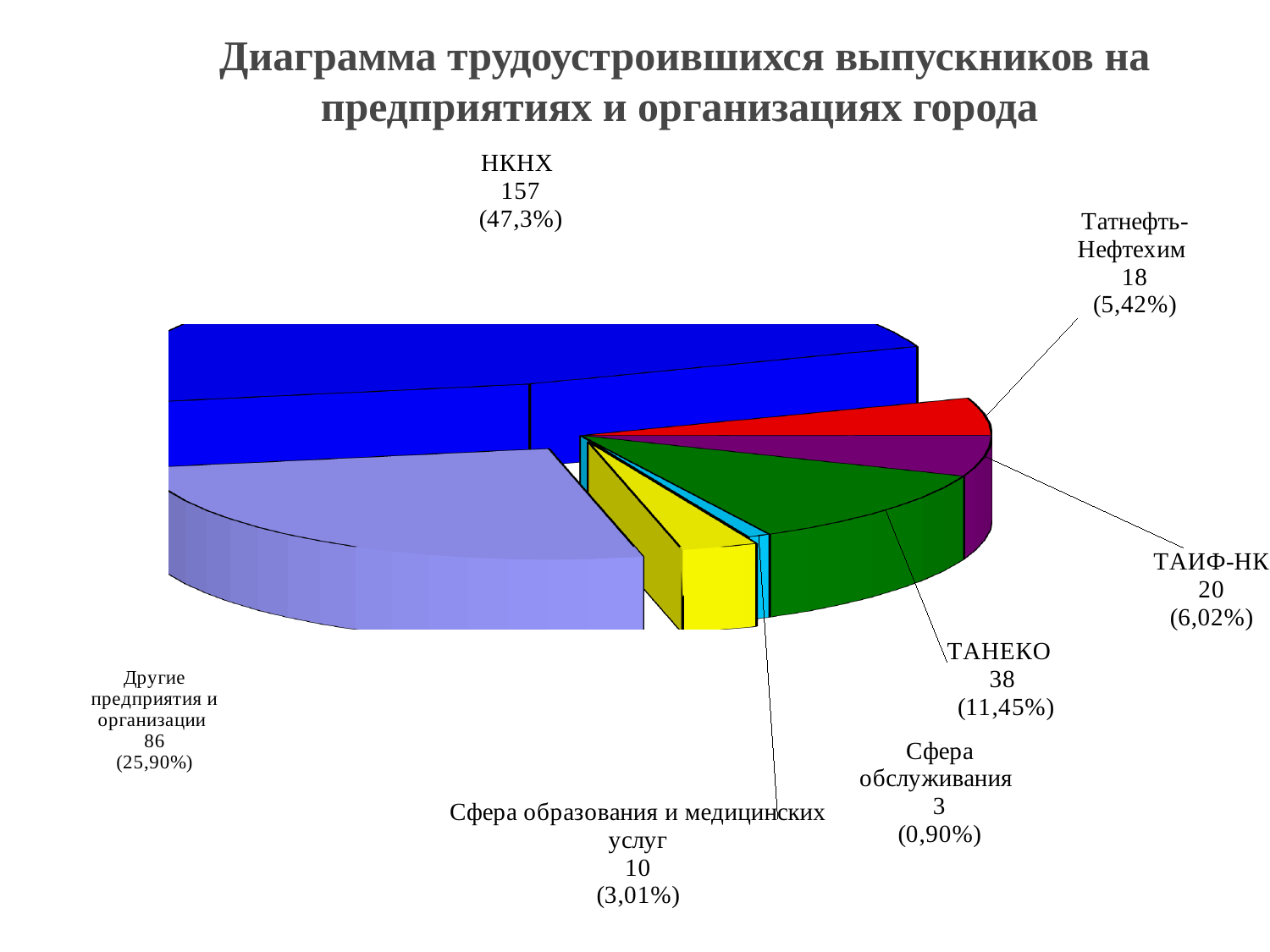
What is the difference between the values for НКНХ and Другие предприятия и организации? 71 What share of the pie does ТАНЕКО represent? 11,45% What share of the pie does Сфера обслуживания represent? 0,90% Which category has the largest slice? НКНХ Which is larger, the value for ТАНЕКО or the value for Сфера образования и медицинских услуг? ТАНЕКО What is the value for Другие предприятия и организации? 86 What type of chart is shown on the slide? pie chart How many slices does the pie chart have? 7 What is the value for НКНХ? 157 What is the difference between the values for ТАИФ-НК and Татнефть-Нефтехим? 2 Which category has the smallest slice? Сфера обслуживания What is the title of the chart? Диаграмма трудоустроившихся выпускников на предприятиях и организациях города